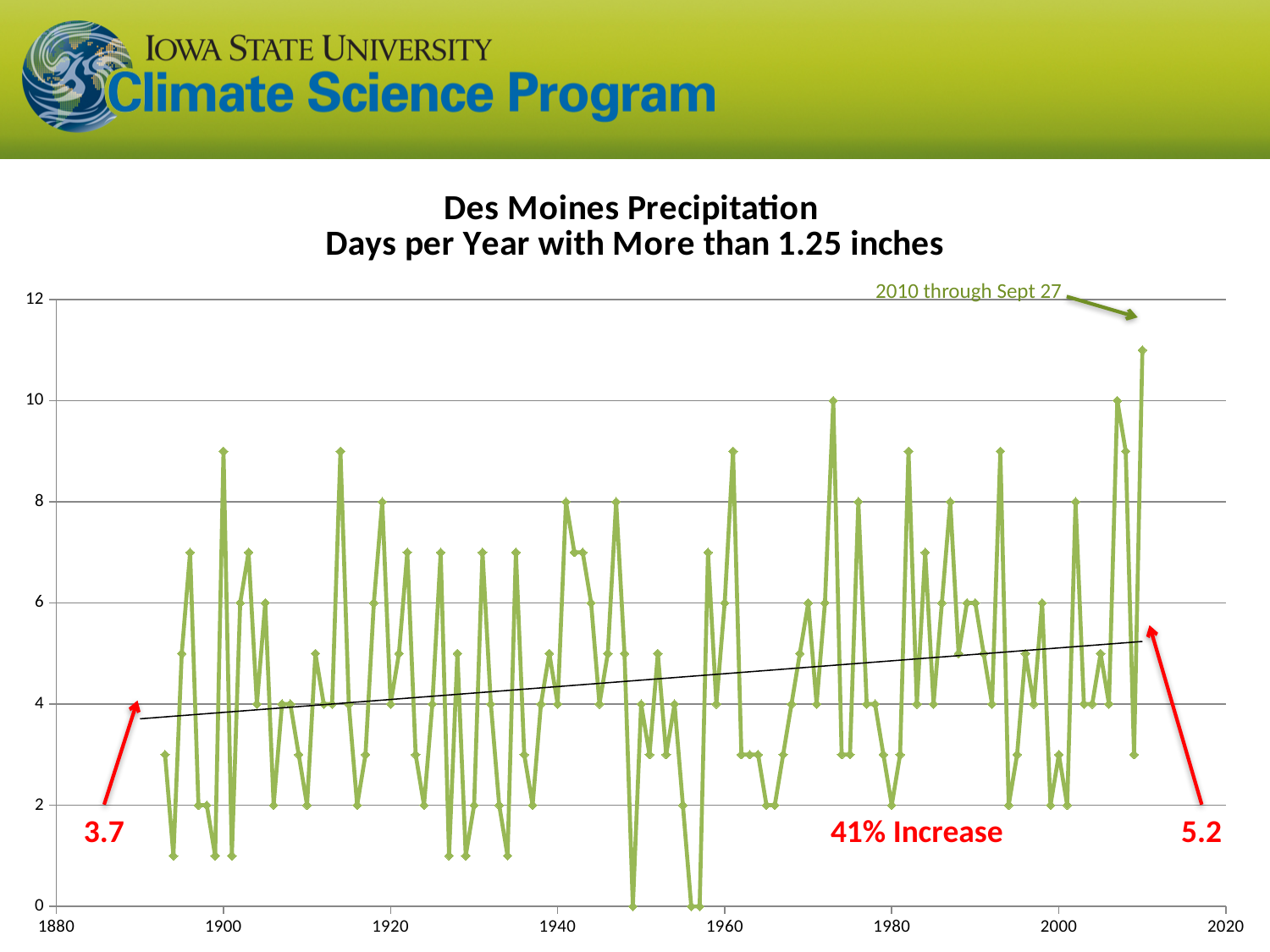
What kind of chart is shown on the slide? line chart What is the title of the chart? Des Moines Precipitation Days per Year with More than 1.25 inches What value is labeled at the end of the trend line on the right side of the chart? 5.2 Is the value for 2010 greater or less than 10? greater What value is labeled at the start of the trend line on the left side of the chart? 3.7 What is the difference between the trend line's end value (5.2) and its start value (3.7)? 1.5 Does the trend line rise or fall from 1890 to 2010? rises Which is larger, the trend line value at the start (3.7) or at the end (5.2)? 5.2 Which year has the highest number of days plotted on the chart? 2010 Is the value for 1957 greater or less than 2? less What percentage increase is printed on the chart? 41% Increase What is the highest value shown on the y-axis? 12